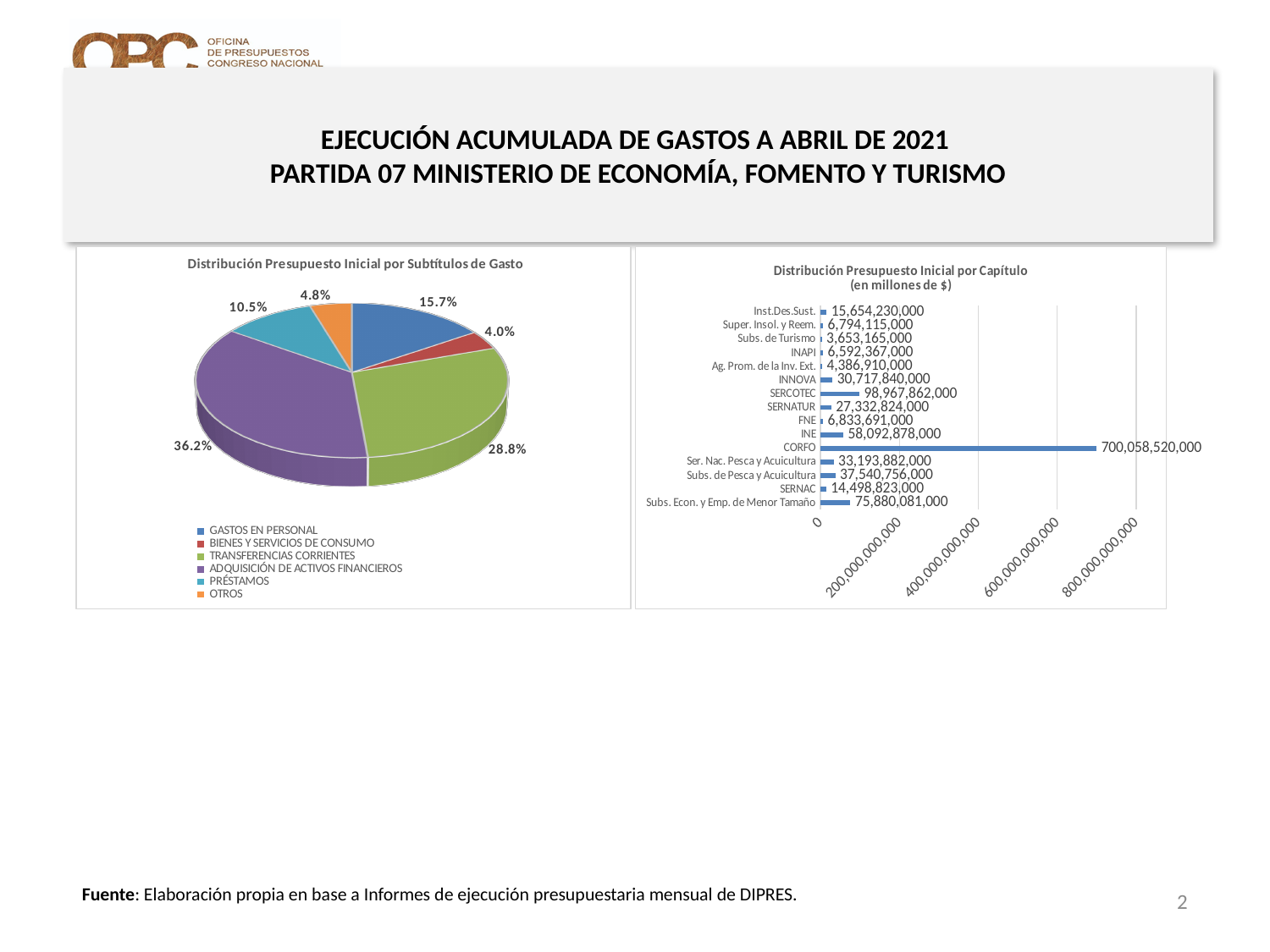
What kind of chart is 'Distribución Presupuesto Inicial por Capítulo'? Bar chart In the chart 'Distribución Presupuesto Inicial por Capítulo', what is the value for SERCOTEC? 98,967,862,000 How many entries does the legend of the pie chart 'Distribución Presupuesto Inicial por Subtítulos de Gasto' list? 6 In the chart 'Distribución Presupuesto Inicial por Capítulo', which is larger, the value for Subs. de Pesca y Acuicultura or Ser. Nac. Pesca y Acuicultura? Subs. de Pesca y Acuicultura In the pie chart 'Distribución Presupuesto Inicial por Subtítulos de Gasto', what share does GASTOS EN PERSONAL have? 15.7% In the chart 'Distribución Presupuesto Inicial por Capítulo', which category has the highest value? CORFO In the chart 'Distribución Presupuesto Inicial por Capítulo', how many categories are plotted? 15 In the chart 'Distribución Presupuesto Inicial por Capítulo', which category has the lowest value? Subs. de Turismo In the pie chart 'Distribución Presupuesto Inicial por Subtítulos de Gasto', what share does ADQUISICIÓN DE ACTIVOS FINANCIEROS have? 36.2% In the chart 'Distribución Presupuesto Inicial por Capítulo', what is the value for INE? 58,092,878,000 In the chart 'Distribución Presupuesto Inicial por Capítulo', what is the difference between the values for INNOVA and SERNATUR? 3,385,016,000 In the chart 'Distribución Presupuesto Inicial por Capítulo', what is the value for CORFO? 700,058,520,000